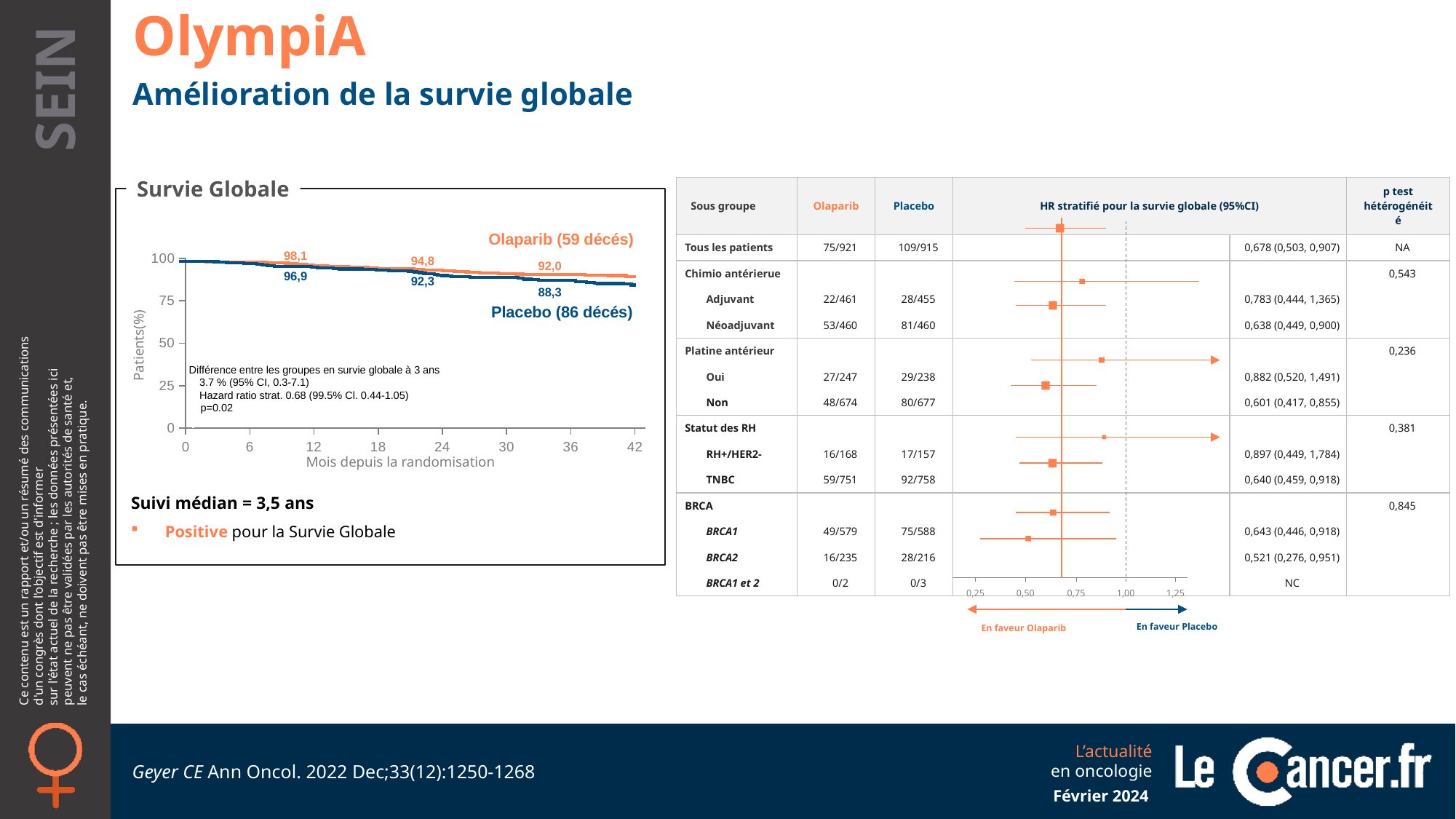
On the 'Survie Globale' chart, what is the title of the x axis? Mois depuis la randomisation On the 'Survie Globale' chart, which curve is higher at the end of follow-up, Olaparib or Placebo? Olaparib On the 'Survie Globale' chart, what is the last labelled value on the Olaparib curve? 92,0 On the 'Survie Globale' chart, what is the difference between the last labelled Olaparib value (92,0) and the last labelled Placebo value (88,3)? 3,7 On the 'Survie Globale' chart, how many deaths are reported for the Olaparib group in its curve label? 59 décés On the 'Survie Globale' chart, how many series (curves) are plotted? 2 In the forest plot on the right, what is the stratified HR (95% CI) for 'Tous les patients'? 0,678 (0,503, 0,907) In the forest plot on the right, is the hazard ratio for 'Néoadjuvant' greater or less than 1,00? less On the 'Survie Globale' chart, do the survival values rise or fall as months since randomisation increase? fall In the forest plot on the right, which subgroup has the lowest hazard ratio point estimate? BRCA2 On the 'Survie Globale' chart, what is the last labelled value on the Placebo curve? 88,3 What kind of chart is the 'Survie Globale' chart on the left of the slide? line chart